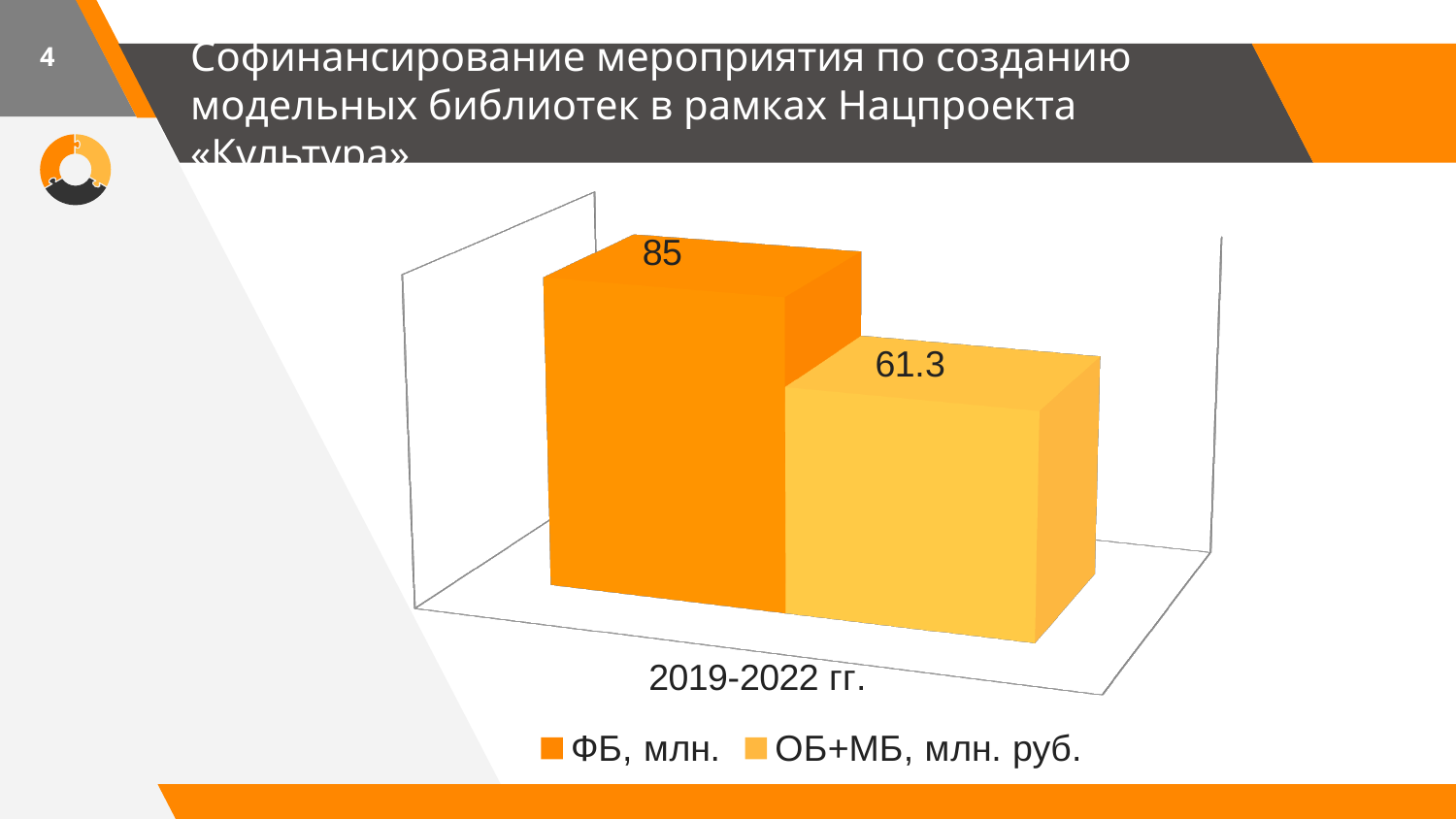
How many series does the legend list? 2 How many categories are shown on the x axis? 1 Which series has the higher value for 2019-2022 гг.? ФБ, млн. What kind of chart is shown on the slide? bar chart What is the total of the two series values for 2019-2022 гг.? 146.3 What is the value for the series "ОБ+МБ, млн. руб." for 2019-2022 гг.? 61.3 What is the difference between the values for "ФБ, млн." and "ОБ+МБ, млн. руб."? 23.7 Which series has the lower value for 2019-2022 гг.? ОБ+МБ, млн. руб. What colour is the bar for the series "ОБ+МБ, млн. руб."? light orange (yellow-orange) What is the category label shown on the x axis? 2019-2022 гг. What is the value for the series "ФБ, млн." for 2019-2022 гг.? 85 Is the value for "ФБ, млн." larger or smaller than the value for "ОБ+МБ, млн. руб."? larger